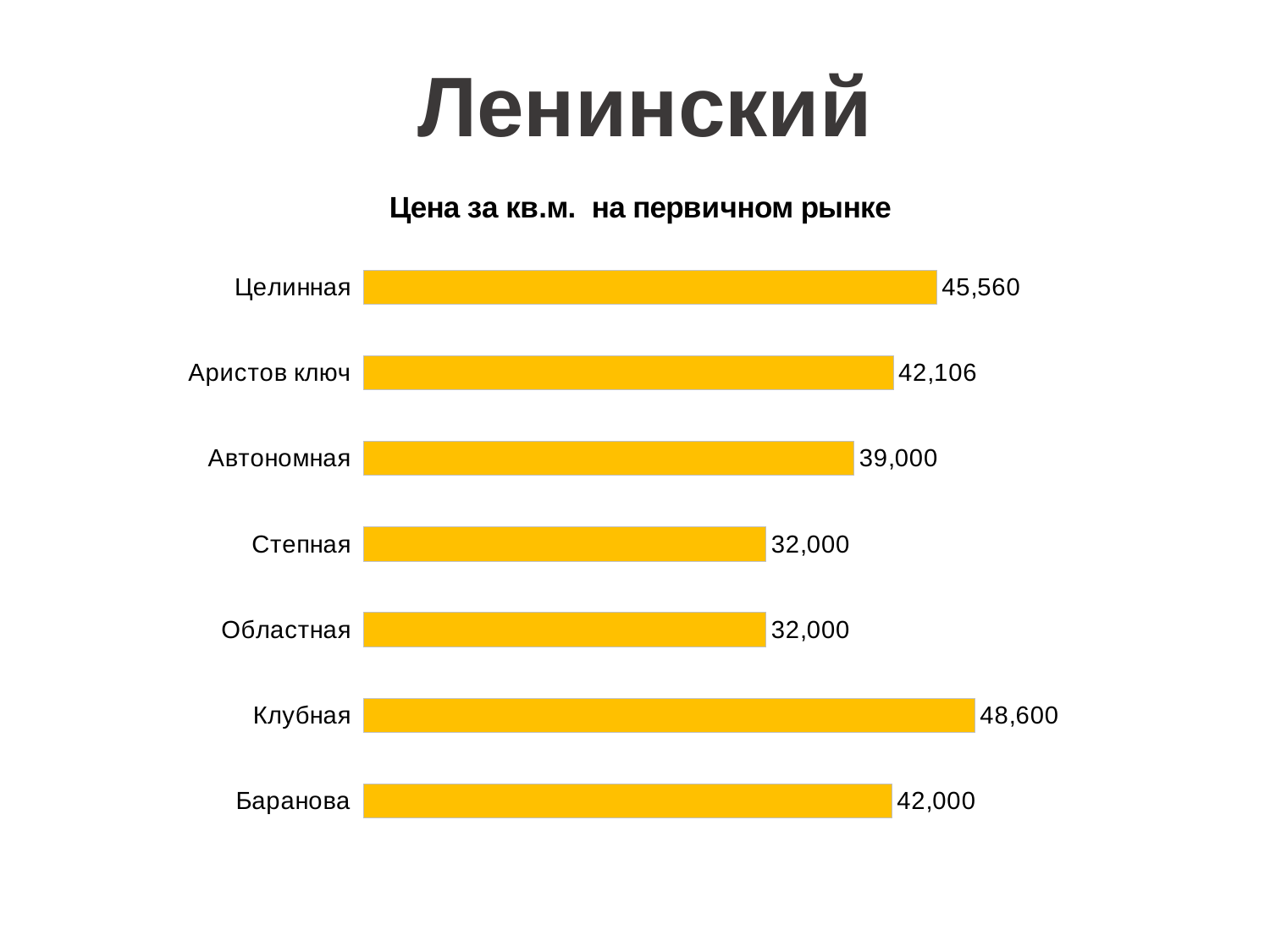
What is the value for Баранова? 42,000 Which category has the highest value? Клубная What is the value for Автономная? 39,000 What is the difference between the values for Клубная and Целинная? 3,040 What is the value for Аристов ключ? 42,106 What is the value for Целинная? 45,560 How many categories are shown in the chart? 7 What kind of chart is shown on the slide? Bar chart What is the title of the chart? Цена за кв.м. на первичном рынке What colour are the bars in the chart? Yellow Which is larger, the value for Автономная or the value for Степная? Автономная What is the difference between the values for Аристов ключ and Баранова? 106